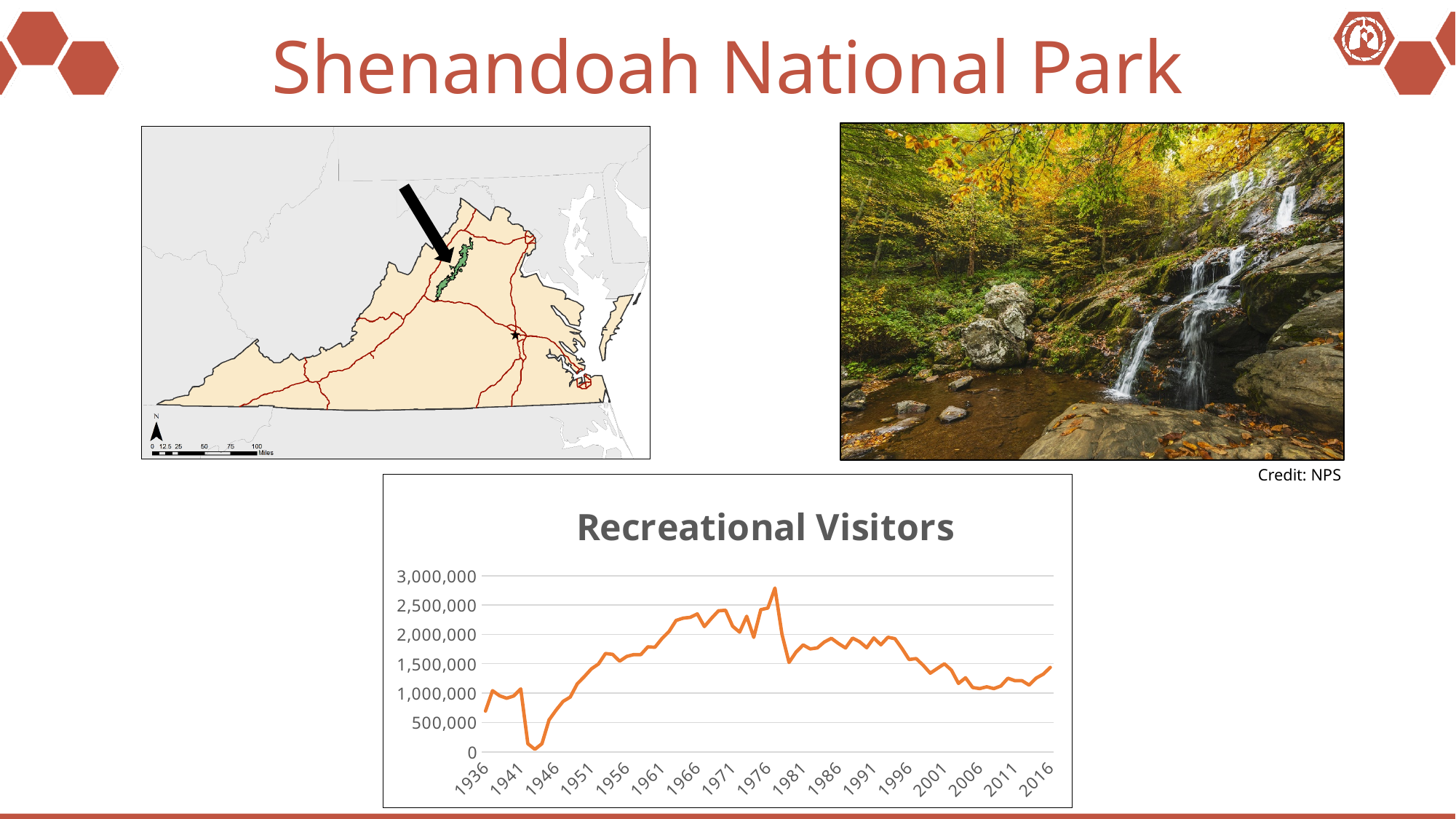
Do the values in the "Recreational Visitors" chart generally rise or fall between 1981 and 2006? fall Is the value for 1936 in the "Recreational Visitors" chart greater or less than 1,000,000? less Is the value for 1966 in the "Recreational Visitors" chart greater or less than 2,000,000? greater What kind of chart is the "Recreational Visitors" chart? line chart Is the peak value of the "Recreational Visitors" line greater or less than 2,500,000? greater How many year labels are shown on the x axis of the "Recreational Visitors" chart? 17 Which year has the larger value in the "Recreational Visitors" chart, 1966 or 2016? 1966 What is the title of the chart on the slide? Recreational Visitors What is the highest value labelled on the y axis of the "Recreational Visitors" chart? 3,000,000